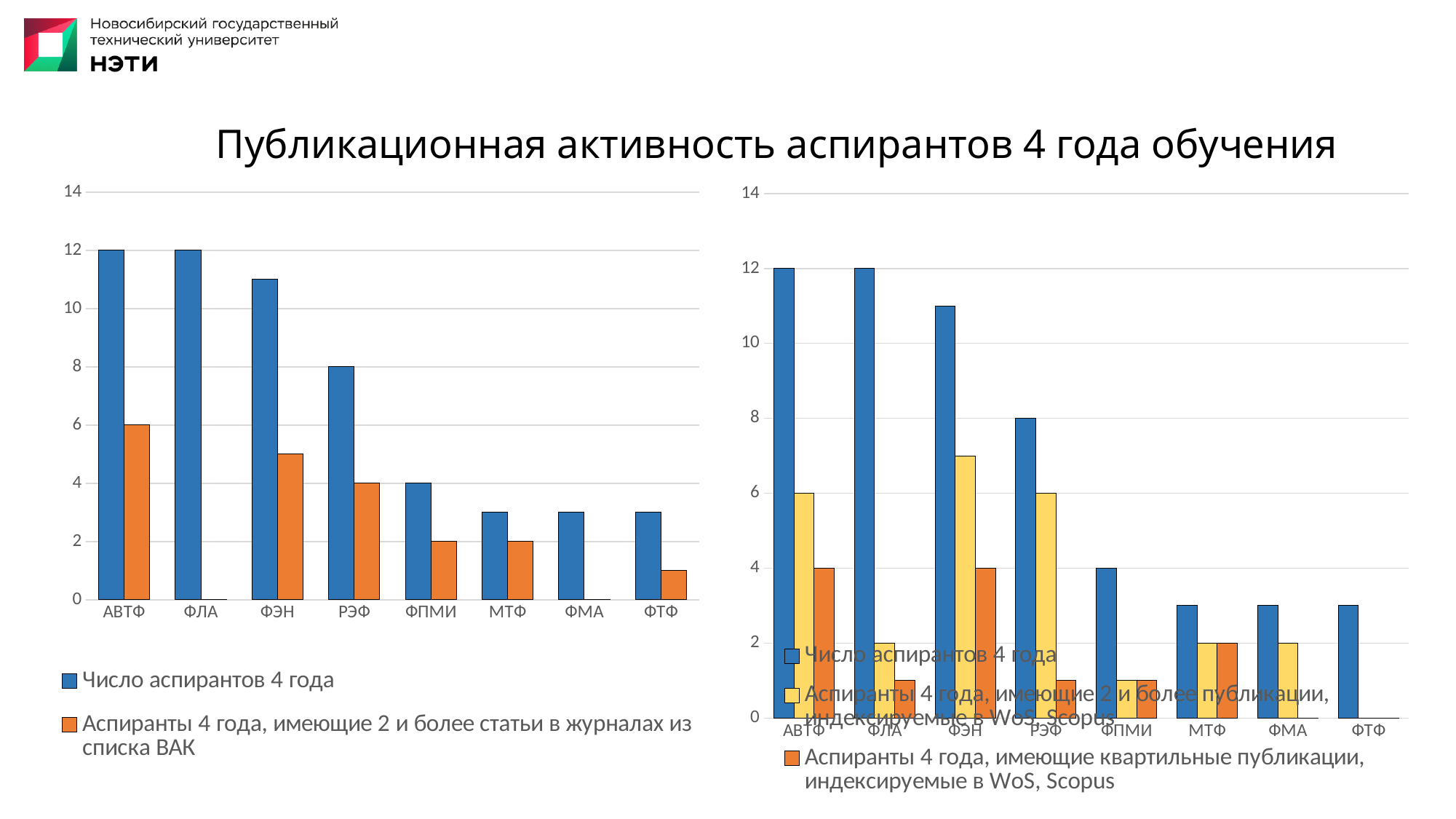
How many series does the legend of the left chart list? 2 In the left chart, what is the value of 'Число аспирантов 4 года' for АВТФ? 12 How many faculty categories are shown on the x axis of the left chart? 8 In the right chart, which faculty has the highest value for 'Аспиранты 4 года, имеющие 2 и более публикации, индексируемые в WoS, Scopus'? ФЭН What type of chart is the left chart on the slide? bar chart How many series does the legend of the right chart list? 3 In the right chart, what is the value of 'Аспиранты 4 года, имеющие квартильные публикации, индексируемые в WoS, Scopus' for АВТФ? 4 In the left chart, what is the value of 'Аспиранты 4 года, имеющие 2 и более статьи в журналах из списка ВАК' for АВТФ? 6 In the left chart, what is the difference between 'Число аспирантов 4 года' and 'Аспиранты 4 года, имеющие 2 и более статьи в журналах из списка ВАК' for АВТФ? 6 In the left chart, which faculty has the highest value for 'Аспиранты 4 года, имеющие 2 и более статьи в журналах из списка ВАК'? АВТФ In the left chart, what is the value of 'Число аспирантов 4 года' for РЭФ? 8 In the left chart, is the value of 'Число аспирантов 4 года' for ФЭН greater or less than 10? greater